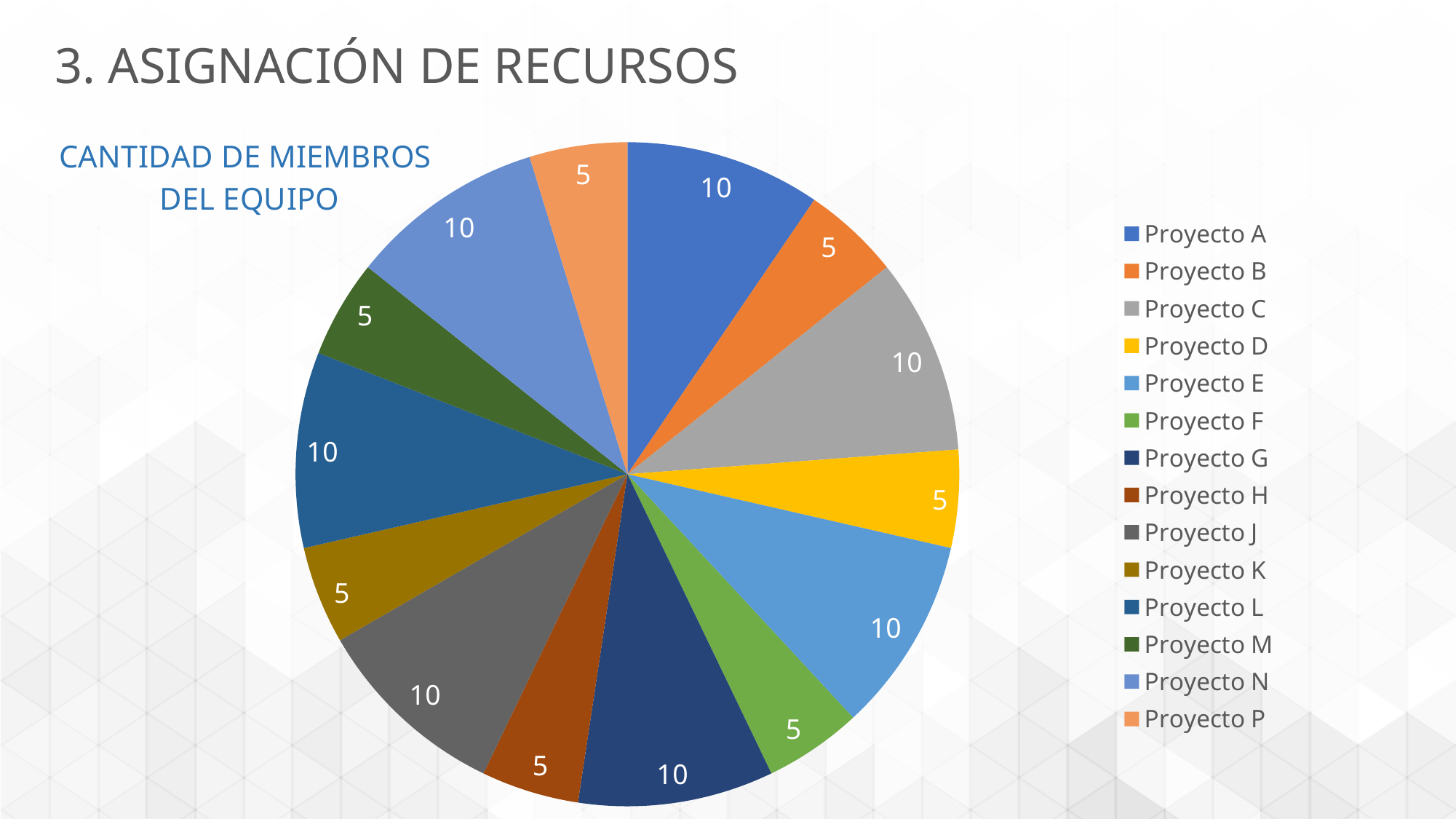
What is the difference between the value for Proyecto E and the value for Proyecto F? 5 What is the value for Proyecto B? 5 Which is larger, the value for Proyecto C or the value for Proyecto H? Proyecto C What is the title of the pie chart? CANTIDAD DE MIEMBROS DEL EQUIPO How many slices (projects) does the pie chart have? 14 Which colour is used for the Proyecto D slice? Yellow What type of chart is shown on the slide? Pie chart What is the value for Proyecto A? 10 What is the value for Proyecto J? 10 What is the total of all the values shown in the pie chart? 105 What is the value for Proyecto P? 5 What is the value for Proyecto D? 5